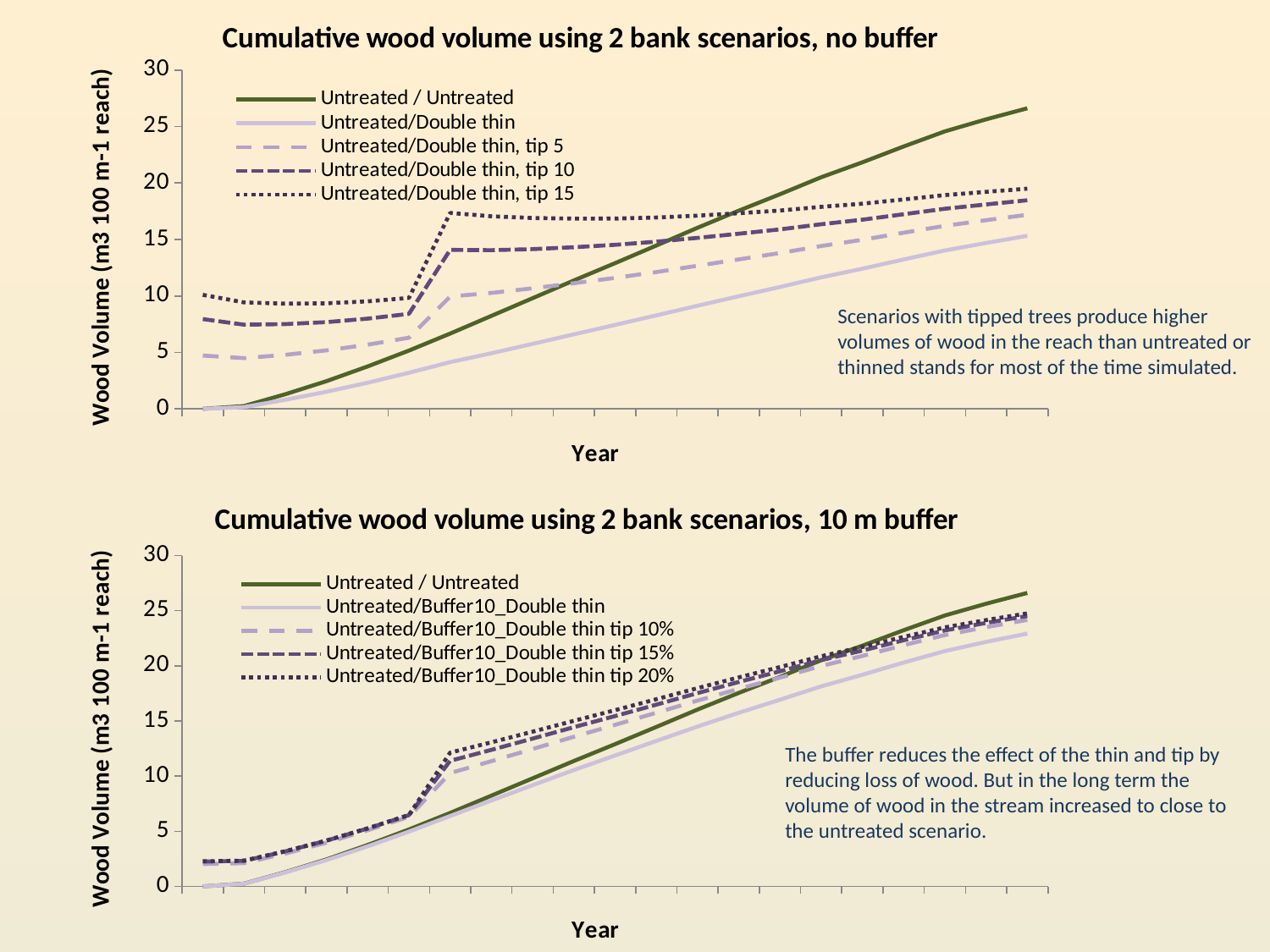
In the bottom chart (10 m buffer), is the final value of the Untreated / Untreated series greater or less than 25? greater In the top chart (no buffer), is the starting value of the Untreated/Double thin, tip 15 series greater or less than 5? greater In the top chart (no buffer), which series has the higher value at the end of the simulation: Untreated / Untreated or Untreated/Double thin? Untreated / Untreated In the top chart (no buffer), is the final value of the Untreated / Untreated series greater or less than 25? greater What type of chart is the top chart, 'Cumulative wood volume using 2 bank scenarios, no buffer'? Line chart What is the title of the bottom chart on the slide? Cumulative wood volume using 2 bank scenarios, 10 m buffer How many series does the legend list in the bottom chart, 'Cumulative wood volume using 2 bank scenarios, 10 m buffer'? 5 In the bottom chart (10 m buffer), does the Untreated / Untreated series rise or fall over the years shown? Rise What is the y-axis label of the top chart, 'Cumulative wood volume using 2 bank scenarios, no buffer'? Wood Volume (m3 100 m-1 reach) How many series does the legend list in the top chart, 'Cumulative wood volume using 2 bank scenarios, no buffer'? 5